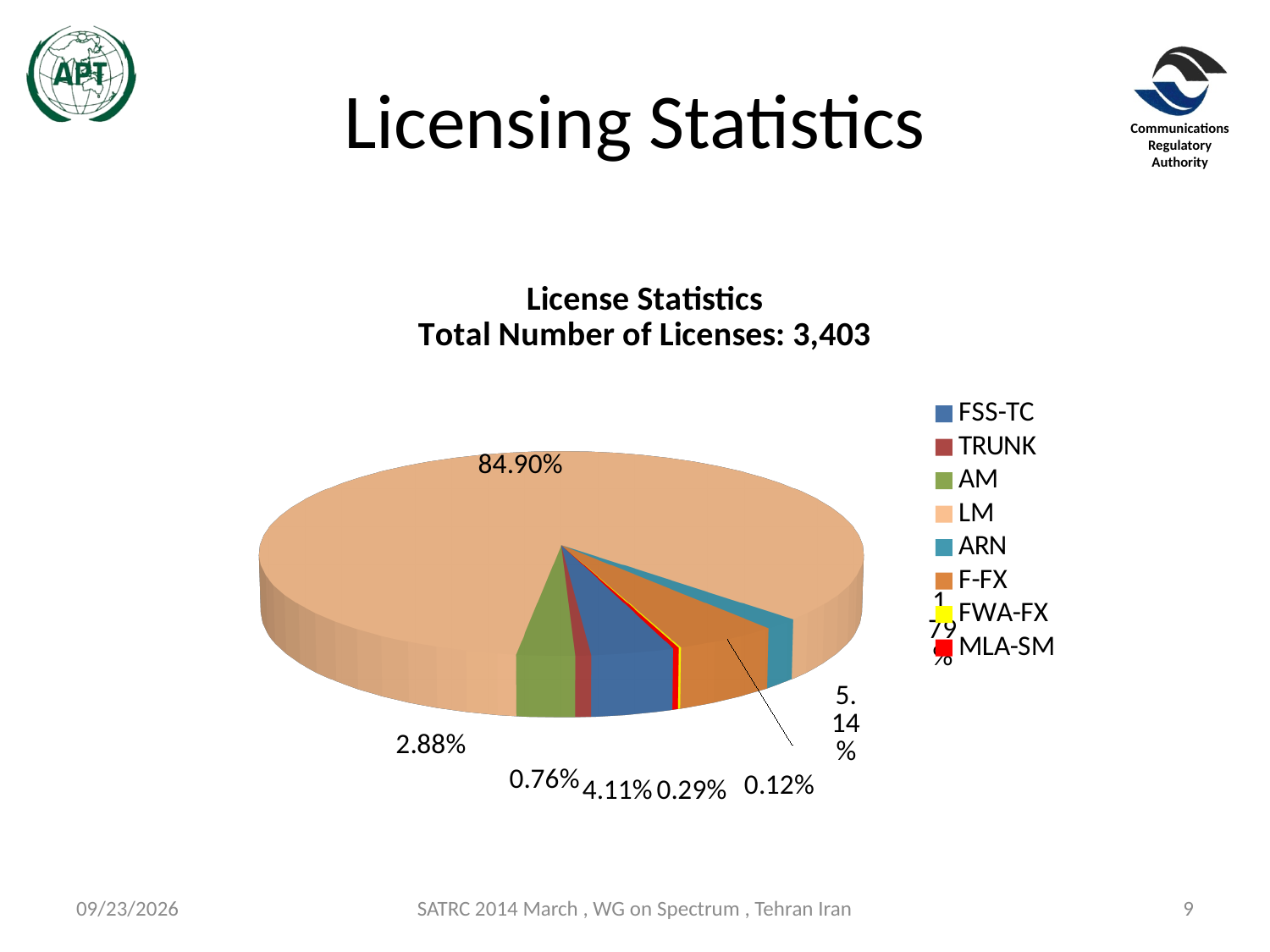
Which legend entry is listed first? FSS-TC Which category has the largest share of the pie? LM What is the total number of licenses stated in the chart title? 3,403 How many categories does the legend list? 8 What percentage share does the LM slice have? 84.90% What type of chart is shown on the slide? pie chart What percentage is shown for the AM slice? 2.88% What is the smallest percentage label shown on the pie chart? 0.12% What is the difference between the LM share (84.90%) and the AM share (2.88%)? 82.02% What percentage is shown for the FSS-TC slice? 4.11% Which is larger, the LM slice or the AM slice? LM What is the title of the chart? License Statistics Total Number of Licenses: 3,403